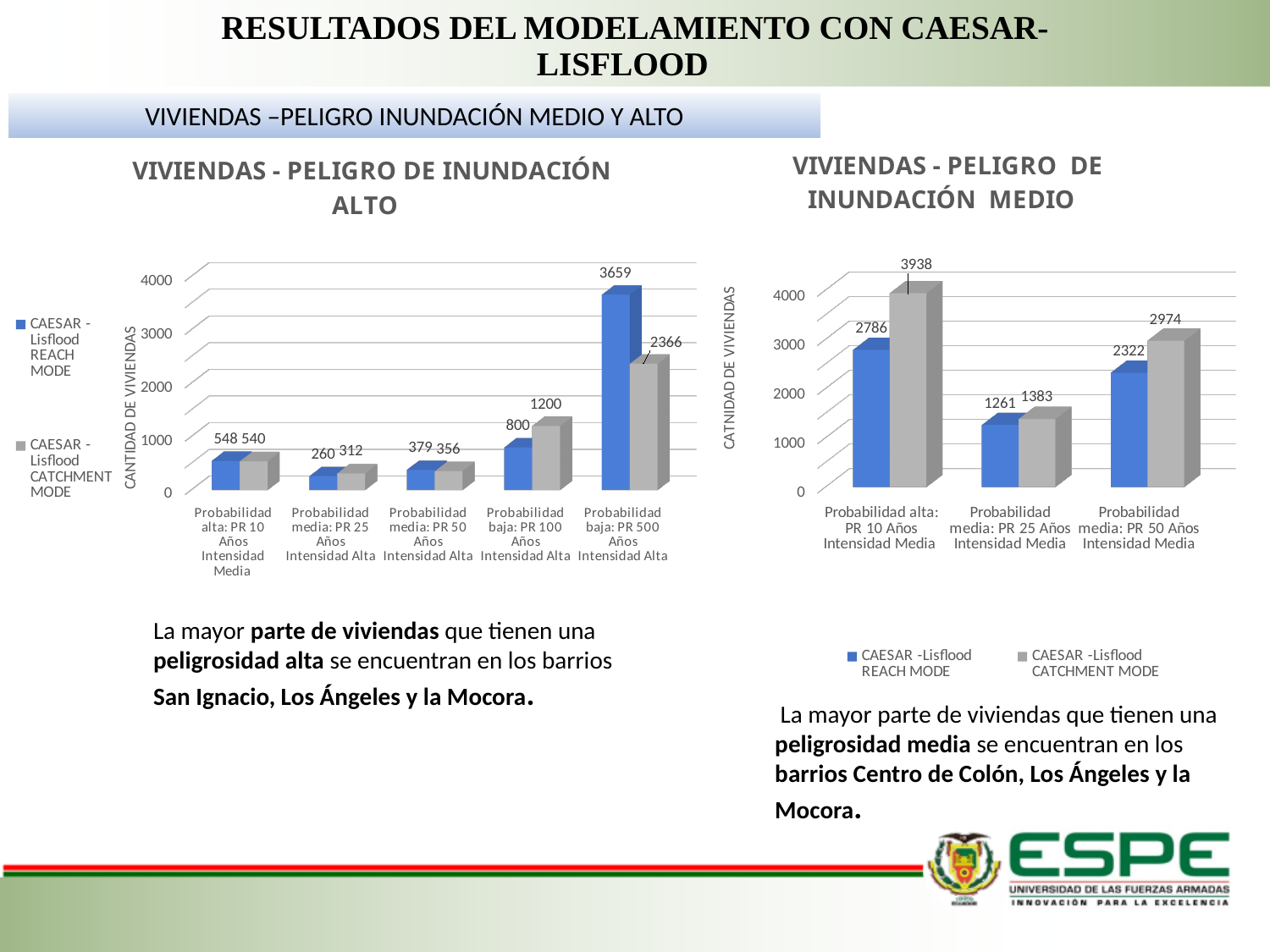
In the 'VIVIENDAS - PELIGRO DE INUNDACIÓN ALTO' chart, what is the CAESAR - Lisflood CATCHMENT MODE value for 'Probabilidad baja: PR 100 Años Intensidad Alta'? 1200 What kind of chart is the 'VIVIENDAS - PELIGRO DE INUNDACIÓN MEDIO' chart? Bar chart In the 'VIVIENDAS - PELIGRO DE INUNDACIÓN ALTO' chart, which category has the lowest CAESAR - Lisflood REACH MODE value? Probabilidad media: PR 25 Años Intensidad Alta How many series does the legend of the 'VIVIENDAS - PELIGRO DE INUNDACIÓN MEDIO' chart list? 2 In the 'VIVIENDAS - PELIGRO DE INUNDACIÓN MEDIO' chart, what is the CAESAR - Lisflood REACH MODE value for 'Probabilidad media: PR 50 Años Intensidad Media'? 2322 In the 'VIVIENDAS - PELIGRO DE INUNDACIÓN MEDIO' chart, what is the difference between the CATCHMENT MODE and REACH MODE values for 'Probabilidad media: PR 50 Años Intensidad Media'? 652 In the 'VIVIENDAS - PELIGRO DE INUNDACIÓN ALTO' chart, what is the CAESAR - Lisflood REACH MODE value for 'Probabilidad baja: PR 500 Años Intensidad Alta'? 3659 In the 'VIVIENDAS - PELIGRO DE INUNDACIÓN ALTO' chart, which is larger for 'Probabilidad media: PR 50 Años Intensidad Alta': REACH MODE or CATCHMENT MODE? REACH MODE In the 'VIVIENDAS - PELIGRO DE INUNDACIÓN ALTO' chart, what is the difference between the REACH MODE and CATCHMENT MODE values for 'Probabilidad baja: PR 500 Años Intensidad Alta'? 1293 In the 'VIVIENDAS - PELIGRO DE INUNDACIÓN ALTO' chart, how many categories are shown on the x axis? 5 In the 'VIVIENDAS - PELIGRO DE INUNDACIÓN MEDIO' chart, what is the CAESAR - Lisflood CATCHMENT MODE value for 'Probabilidad alta: PR 10 Años Intensidad Media'? 3938 In the 'VIVIENDAS - PELIGRO DE INUNDACIÓN MEDIO' chart, which category has the lowest CAESAR - Lisflood CATCHMENT MODE value? Probabilidad media: PR 25 Años Intensidad Media